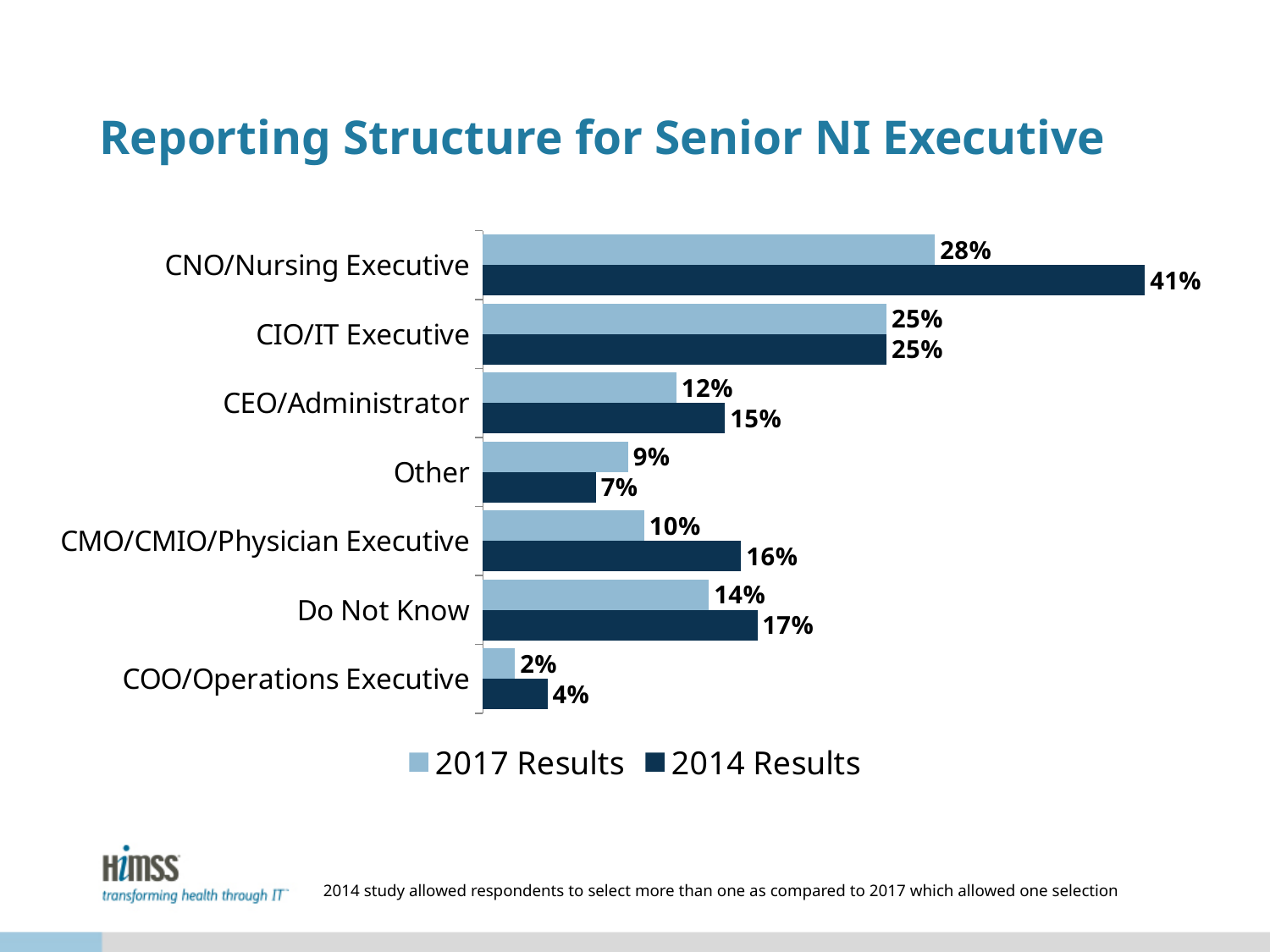
Which category has the lowest 2017 Results value? COO/Operations Executive What is the title of the chart? Reporting Structure for Senior NI Executive Which category has the highest 2014 Results value? CNO/Nursing Executive What is the 2017 Results value for Do Not Know? 14% How many categories are shown on the chart? 7 What is the 2017 Results value for CNO/Nursing Executive? 28% What is the difference between the 2014 Results and 2017 Results values for CNO/Nursing Executive? 13% Which is larger for CEO/Administrator: the 2017 Results value or the 2014 Results value? 2014 Results What is the difference between the 2017 Results and 2014 Results values for Other? 2% How many series does the legend list? 2 What kind of chart is shown on the slide? Bar chart What is the 2014 Results value for CMO/CMIO/Physician Executive? 16%